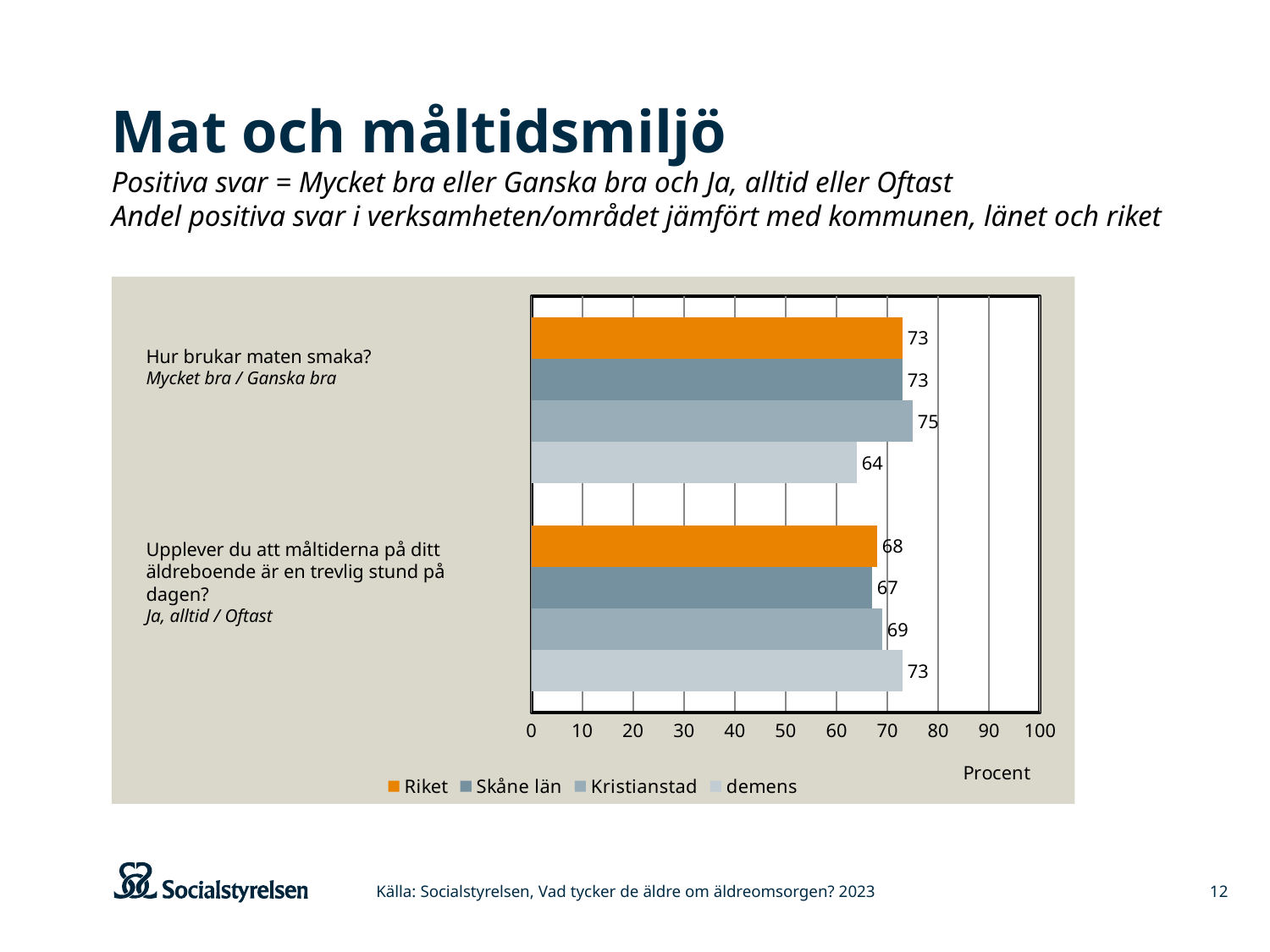
Which series has the highest value for "Upplever du att måltiderna på ditt äldreboende är en trevlig stund på dagen?" demens For "Upplever du att måltiderna på ditt äldreboende är en trevlig stund på dagen?", which is larger: the value for demens or the value for Riket? demens Which series has the lowest value for "Hur brukar maten smaka?" demens How many series does the legend list? 4 What is the value for Riket on the question "Upplever du att måltiderna på ditt äldreboende är en trevlig stund på dagen?" 68 What is the value for Skåne län on the question "Upplever du att måltiderna på ditt äldreboende är en trevlig stund på dagen?" 67 Which series has the highest value for "Hur brukar maten smaka?" Kristianstad What is the value for demens on the question "Hur brukar maten smaka?" 64 What is the label of the x axis? Procent What is the difference between the Kristianstad and demens values for "Hur brukar maten smaka?" 11 What kind of chart is shown on the slide? Bar chart What is the value for Kristianstad on the question "Hur brukar maten smaka?" 75